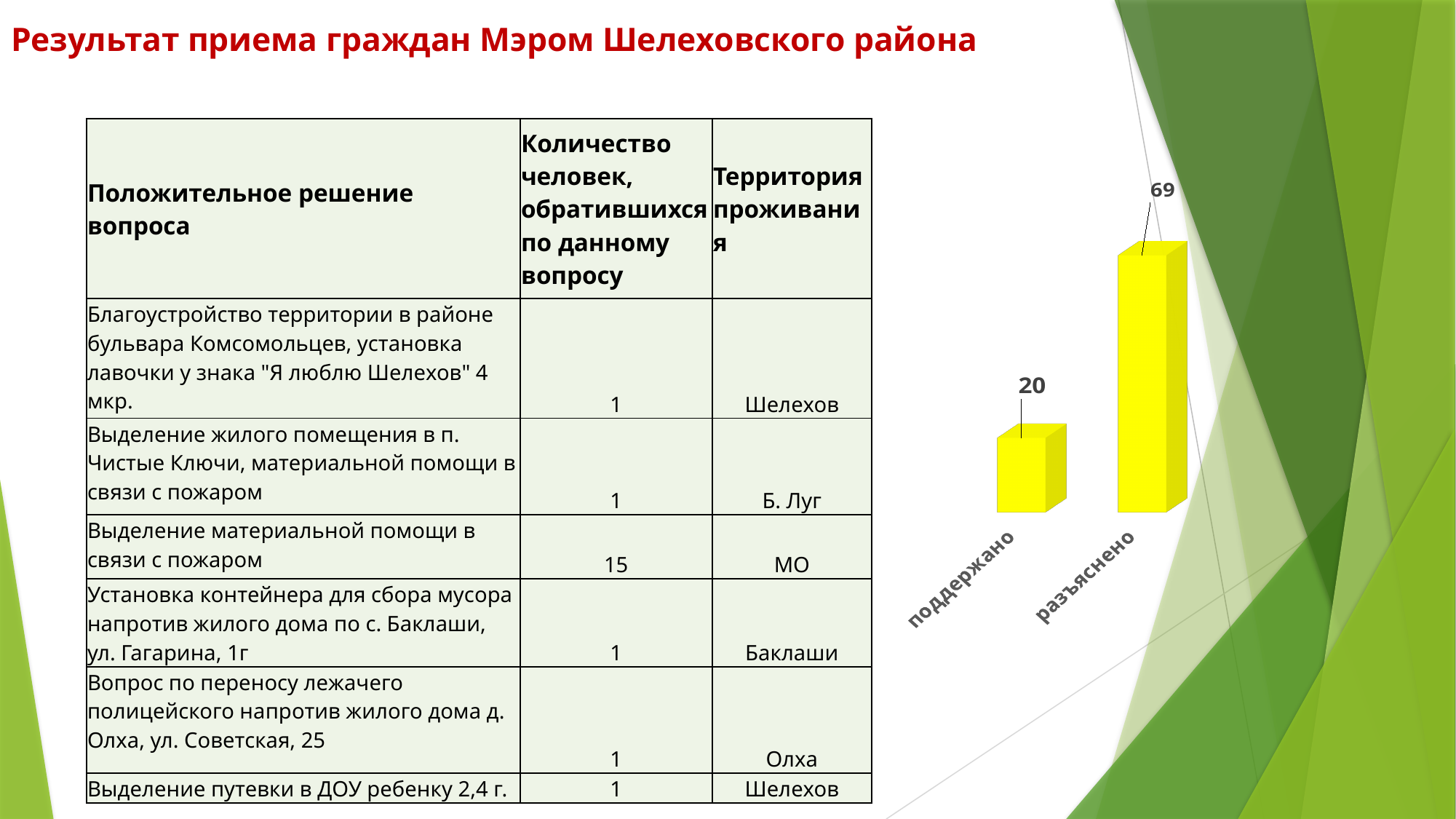
Do the values in the bar chart rise or fall from left to right? rise What is the difference between the values for "разъяснено" and "поддержано" in the bar chart? 49 What is the value for "поддержано" in the bar chart? 20 What is the value for "разъяснено" in the bar chart? 69 What colour are the bars in the bar chart? yellow What kind of chart is shown on the right side of the slide? bar chart Which category has the lowest value in the bar chart? поддержано Which category has the highest value in the bar chart? разъяснено How many categories are shown in the bar chart? 2 Which is larger in the bar chart: "поддержано" or "разъяснено"? разъяснено What is the total of the two values shown in the bar chart? 89